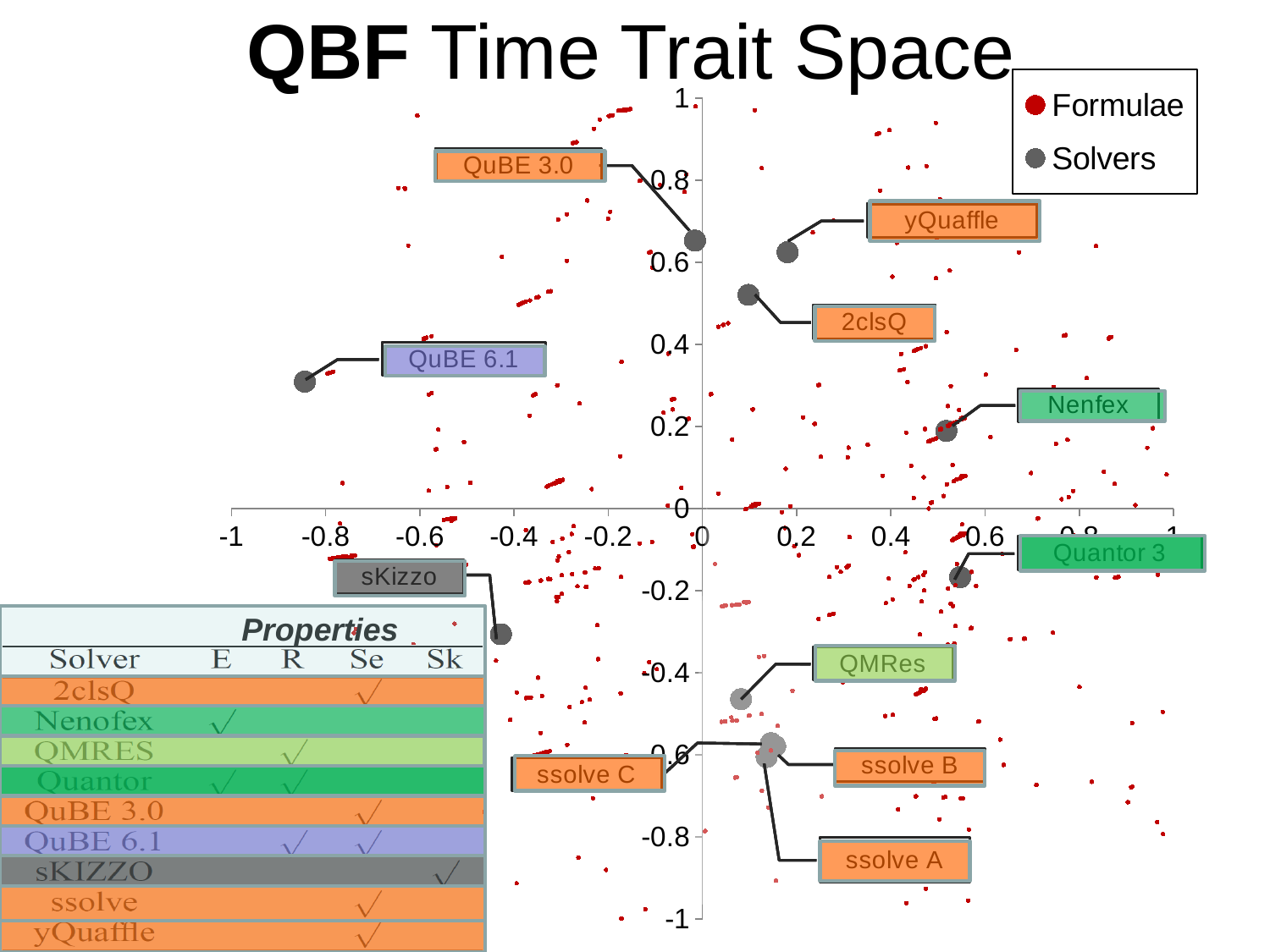
Is the horizontal-axis value for the QuBE 6.1 solver point greater or less than -0.6? less What is the title of the chart? QBF Time Trait Space Is the vertical-axis value for the QMRes solver point greater or less than -0.4? less How many series does the chart legend list? 2 Which solver point has the higher vertical-axis value, Quantor 3 or QMRes? Quantor 3 Is the horizontal-axis value for the Nenfex solver point greater or less than 0.4? greater Which solver point lies furthest to the left on the horizontal axis? QuBE 6.1 What are the two series named in the chart legend? Formulae and Solvers How many labelled solver points are plotted on the chart? 11 What kind of chart is shown on the slide? scatter chart